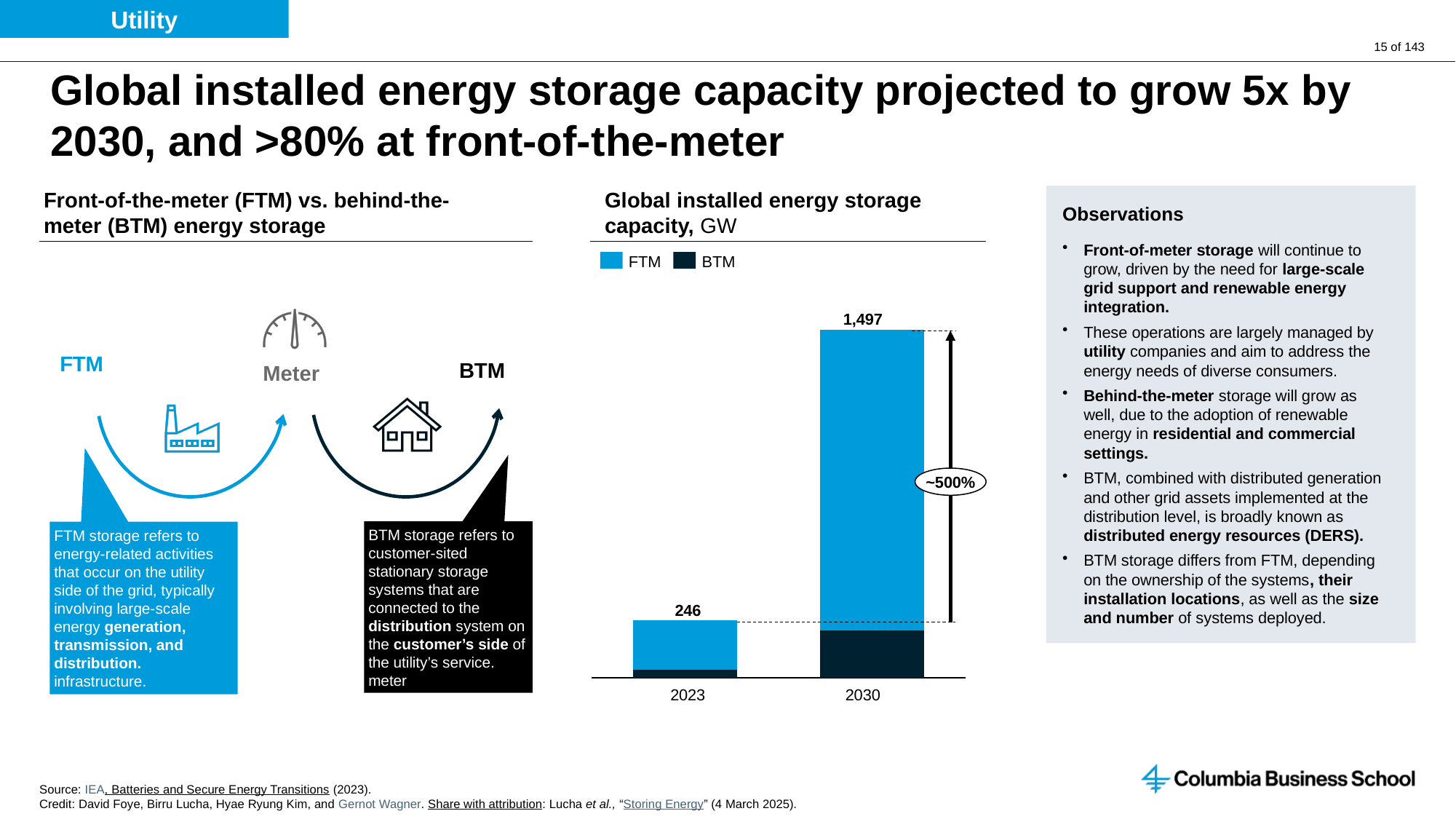
What is the total global installed energy storage capacity shown for 2023? 246 Is the total for 2030 larger or smaller than the total for 2023? larger How many years are shown on the x axis of the chart? 2 How many series does the chart legend list? 2 What unit is the global installed energy storage capacity chart measured in? GW What kind of chart is used to show global installed energy storage capacity? stacked bar chart What is the difference between the 2030 and 2023 total installed capacity values? 1,251 What is the total global installed energy storage capacity shown for 2030? 1,497 Which year has the lower total installed energy storage capacity? 2023 Does total installed energy storage capacity rise or fall from 2023 to 2030? rise Which year has the higher total installed energy storage capacity? 2030 What percentage growth is annotated on the chart between 2023 and 2030? ~500%